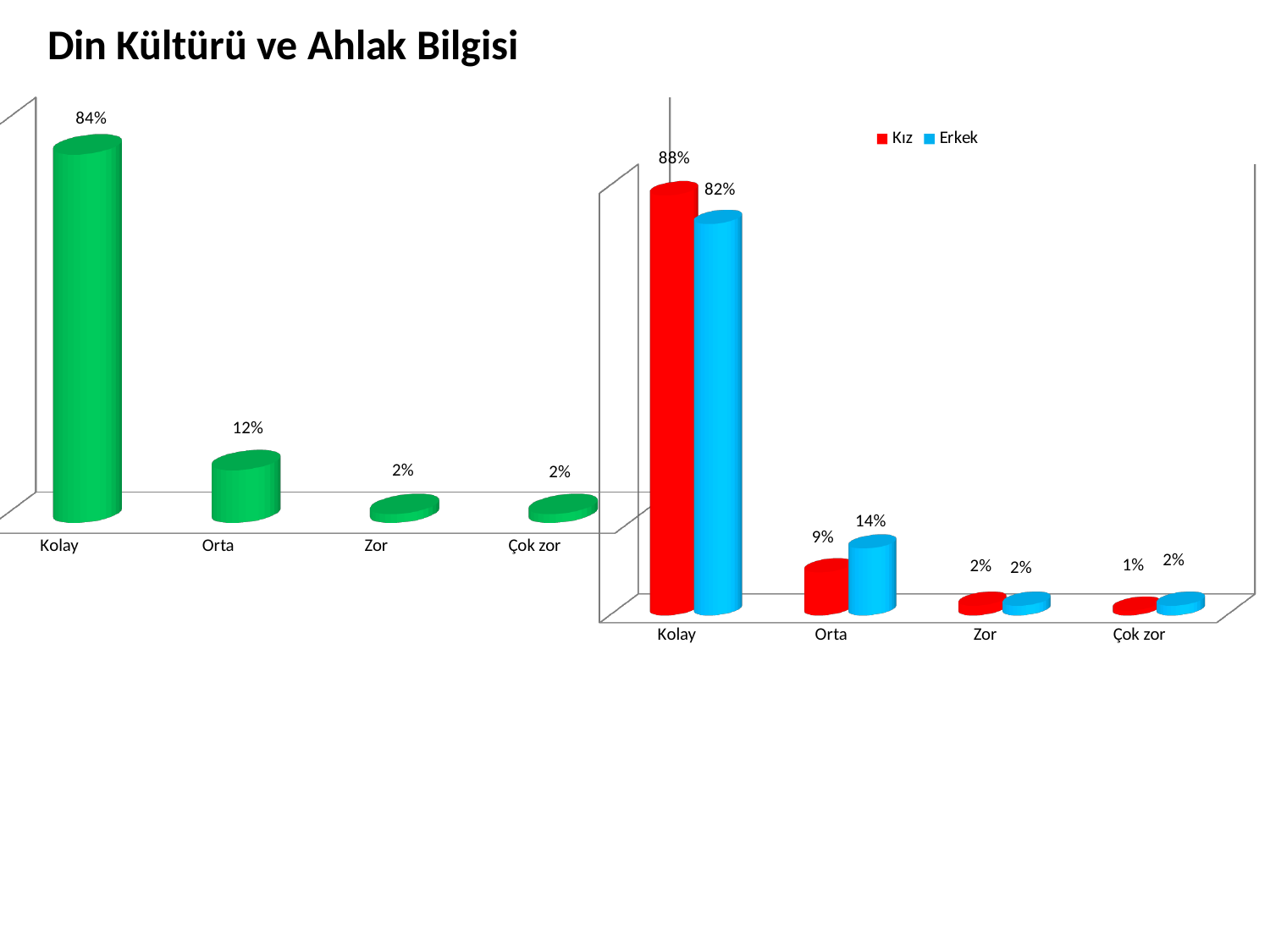
In the left chart, what is the value for Kolay? 84% In the right chart, how many series does the legend list? 2 In the right chart, what is the Kız value for Çok zor? 1% In the left chart, what is the difference between the values for Kolay and Orta? 72% In the left chart, what is the value for Orta? 12% In the right chart, what is the difference between the Kız and Erkek values for Kolay? 6% In the left chart, which category has the highest value? Kolay In the left chart, how many categories are shown on the x axis? 4 In the right chart, what is the Erkek value for Orta? 14% In the right chart, which is larger for Orta, Kız or Erkek? Erkek What kind of chart is the right chart? Bar chart In the right chart, what is the Kız value for Kolay? 88%